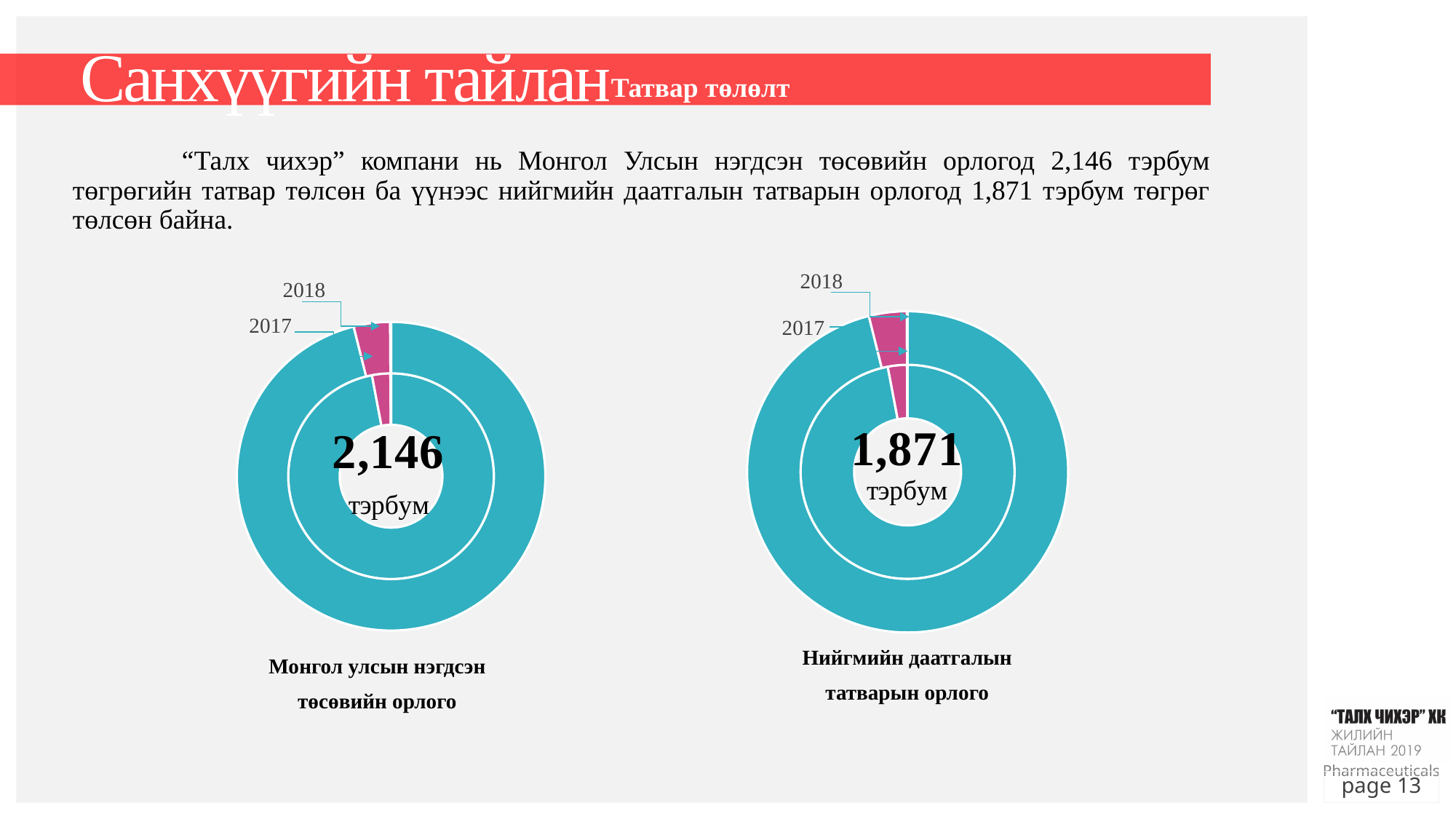
Which chart shows the larger centre value, "Монгол улсын нэгдсэн төсөвийн орлого" or "Нийгмийн даатгалын татварын орлого"? Монгол улсын нэгдсэн төсөвийн орлого How many charts are shown on the slide? 2 What is the title of the chart on the right side of the slide? Нийгмийн даатгалын татварын орлого How many rings (years) does the "Нийгмийн даатгалын татварын орлого" doughnut chart have? 2 In the "Нийгмийн даатгалын татварын орлого" chart, which colour is used for the larger slice of each ring? Teal What kind of chart is used for "Монгол улсын нэгдсэн төсөвийн орлого"? Doughnut chart What is the difference between the centre values of the left chart (2,146) and the right chart (1,871)? 275 In the "Нийгмийн даатгалын татварын орлого" chart, what value is printed in the centre? 1,871 тэрбум In the "Монгол улсын нэгдсэн төсөвийн орлого" chart, which years are labelled on the rings? 2017 and 2018 In the "Монгол улсын нэгдсэн төсөвийн орлого" chart, what value is printed in the centre? 2,146 тэрбум